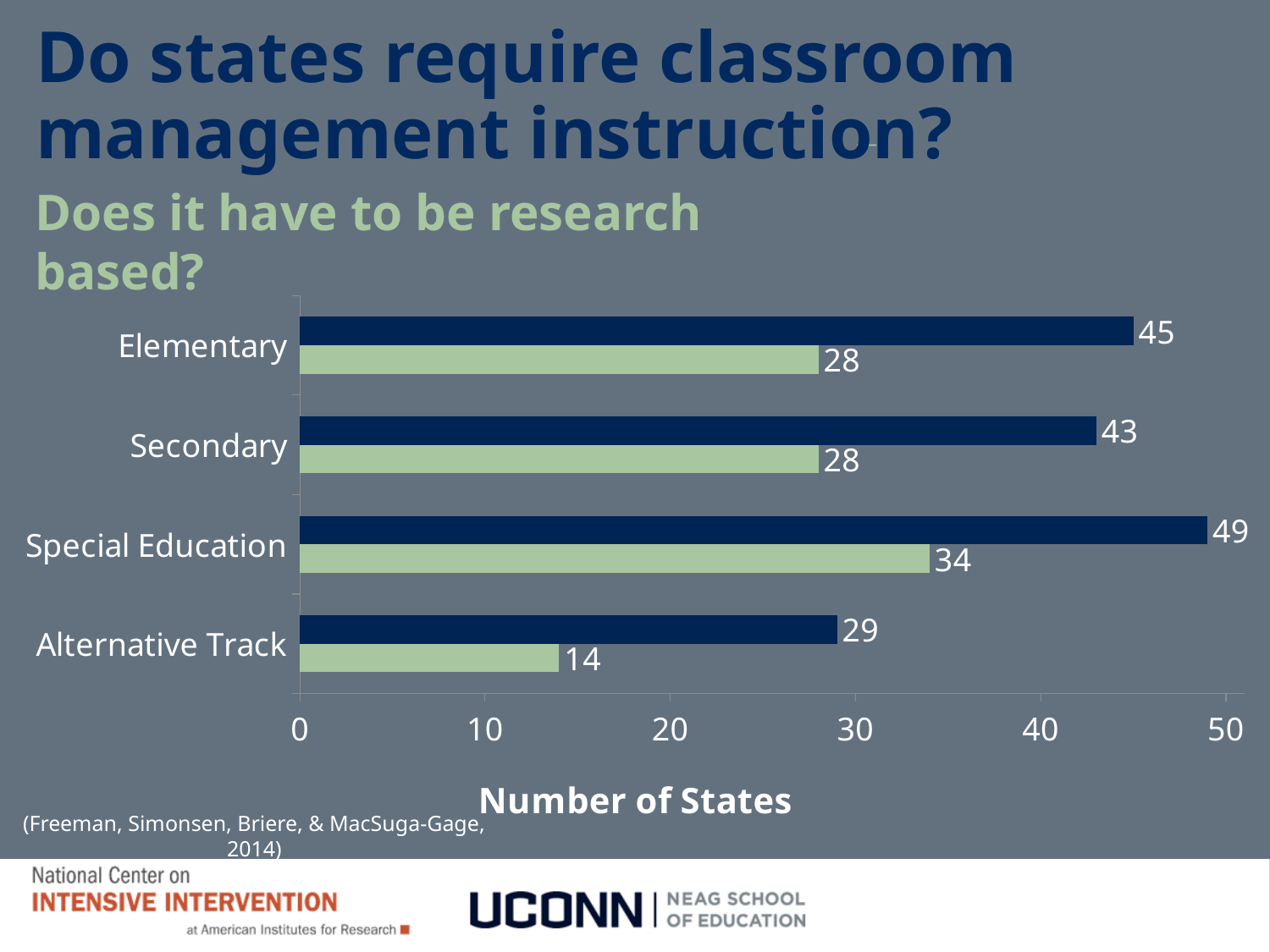
What is the difference between the dark blue bars for Elementary and Secondary? 2 What is the value of the dark blue bar for Special Education? 49 What is the label of the horizontal axis? Number of States Which category has the lowest light green bar? Alternative Track What is the difference between the dark blue and light green bars for Special Education? 15 What is the value of the light green bar for Secondary? 28 Which category has the highest dark blue bar? Special Education What is the value of the light green bar for Alternative Track? 14 What is the value of the dark blue bar for Elementary? 45 What kind of chart is shown on the slide? Bar chart Which is larger: the dark blue bar for Alternative Track or the light green bar for Special Education? Light green bar for Special Education How many categories are shown on the chart? 4